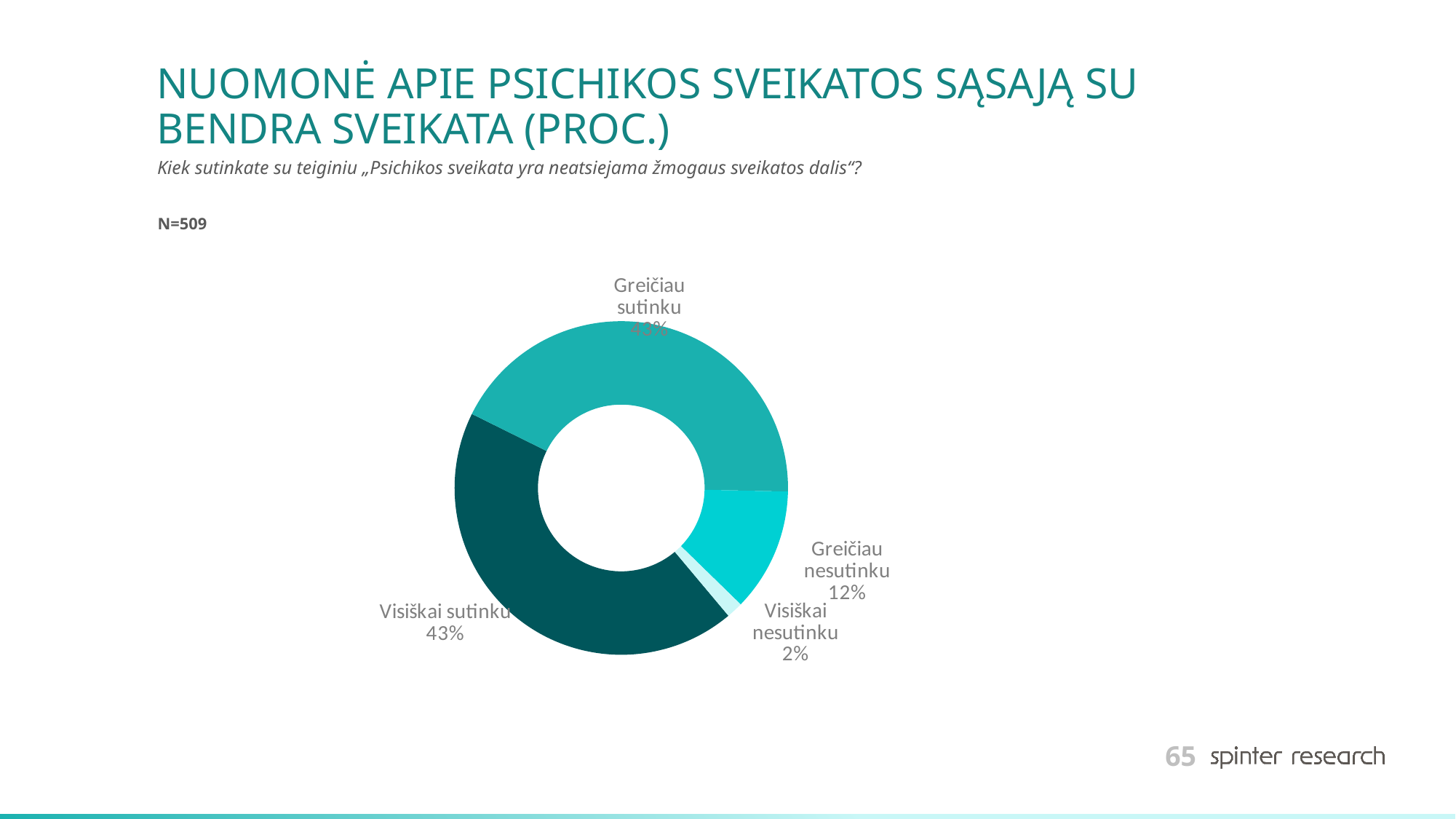
What is the difference in percentage points between "Greičiau nesutinku" and "Visiškai nesutinku"? 10 What type of chart is shown on the slide? Pie chart (donut) What percentage of respondents answered "Visiškai sutinku"? 43% What percentage of respondents answered "Greičiau nesutinku"? 12% Which response category has the smallest share of the chart? Visiškai nesutinku Which is larger, the share for "Visiškai sutinku" or the share for "Greičiau nesutinku"? Visiškai sutinku What percentage of respondents answered "Visiškai nesutinku"? 2% What percentage of respondents answered "Greičiau sutinku"? 43% What is the sample size (N) stated on the slide? N=509 Which is larger, the share for "Greičiau nesutinku" or the share for "Visiškai nesutinku"? Greičiau nesutinku What is the difference in percentage points between "Visiškai sutinku" and "Greičiau nesutinku"? 31 How many response categories are shown in the chart? 4